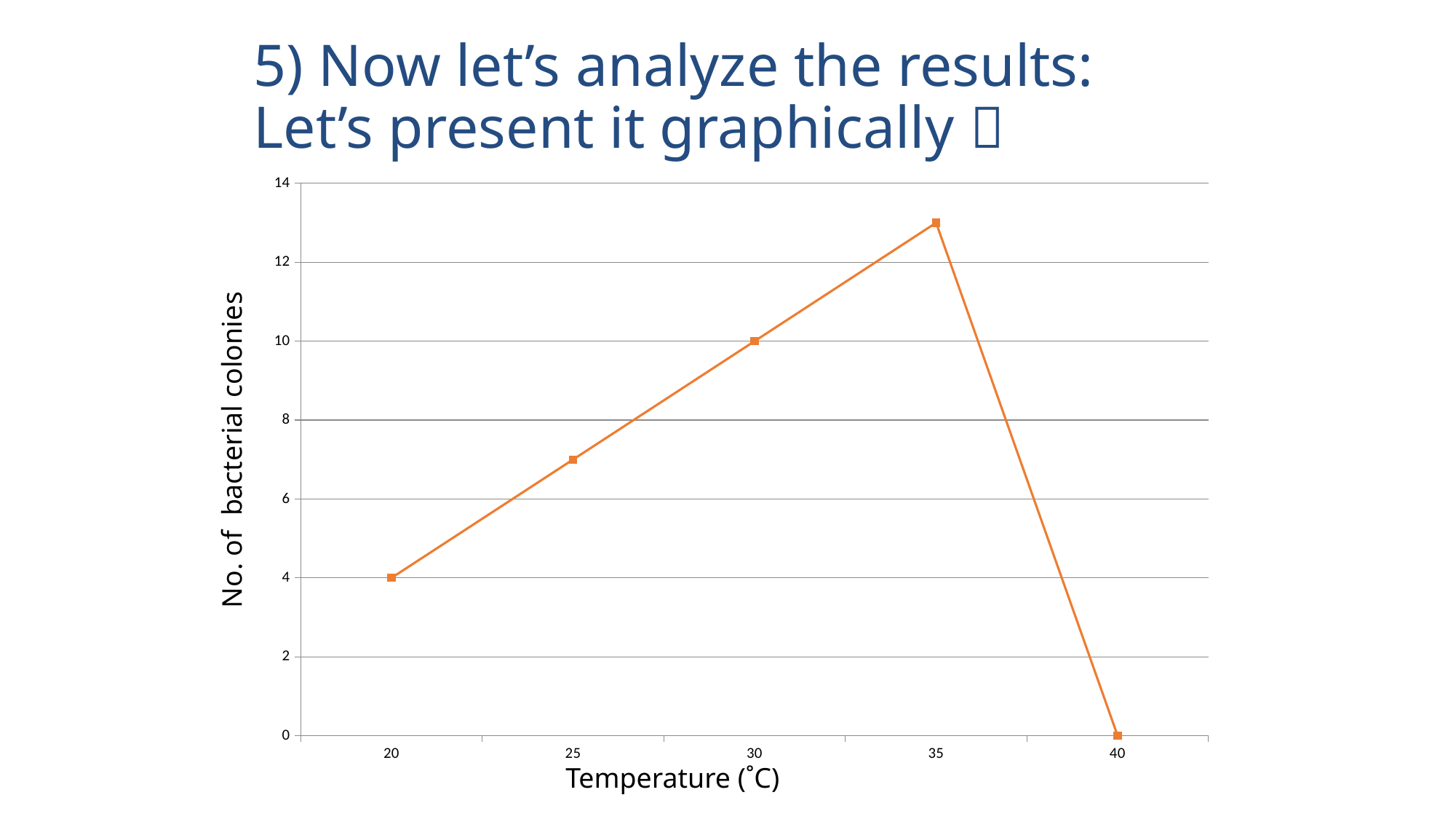
What type of chart is shown on the slide? Line chart At which temperature is the number of bacterial colonies lowest? 40 Which temperature has more bacterial colonies, 25 °C or 35 °C? 35 What is the number of bacterial colonies at 40 °C? 0 What is the number of bacterial colonies at 20 °C? 4 Is the number of bacterial colonies at 35 °C greater or less than 12? greater At which temperature is the number of bacterial colonies highest? 35 What is the label of the x axis? Temperature (°C) How many temperature points are plotted on the chart? 5 What is the difference in the number of bacterial colonies between 30 °C and 20 °C? 6 Is the number of bacterial colonies at 25 °C greater or less than 6? greater What is the number of bacterial colonies at 30 °C? 10